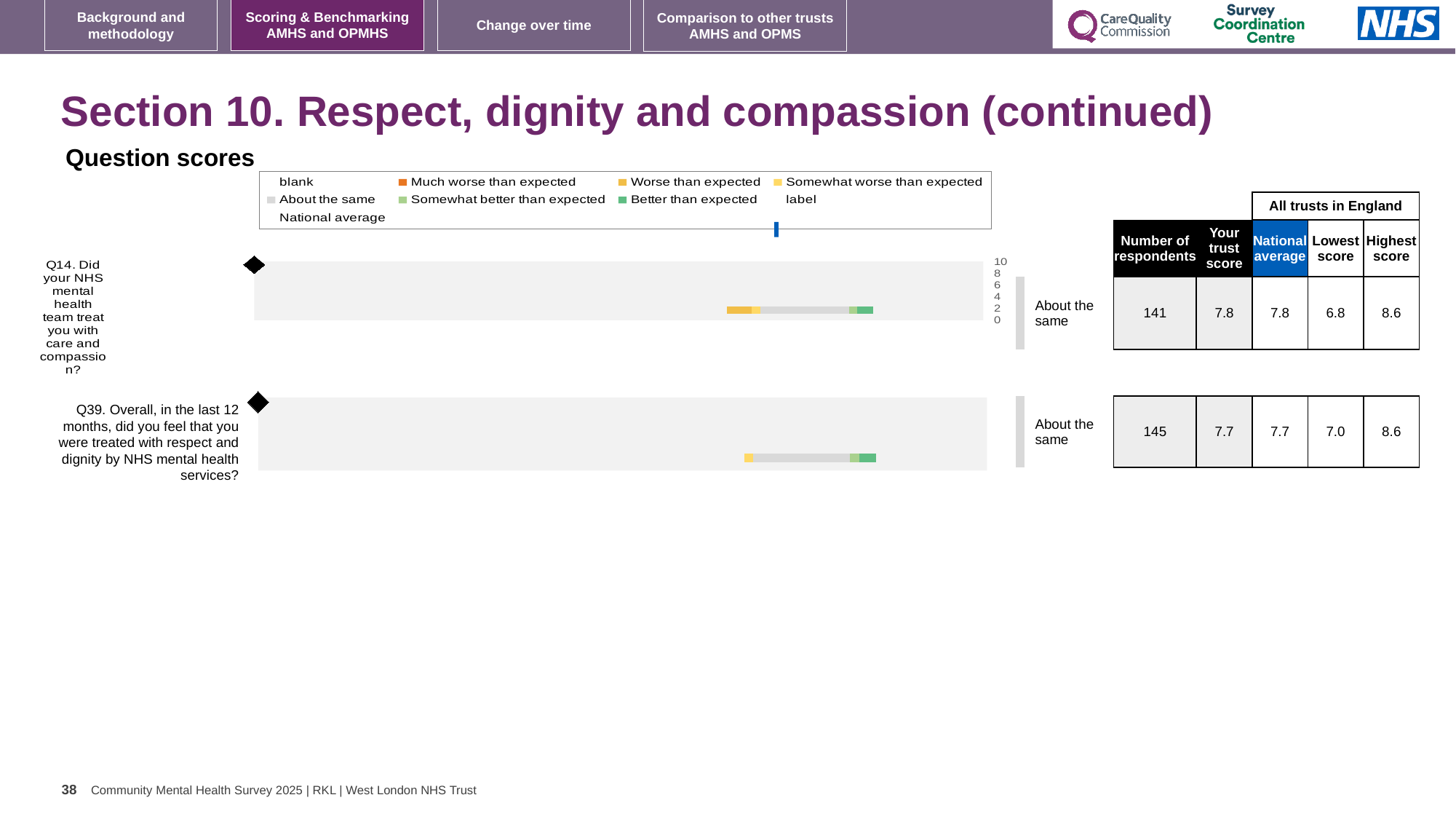
What is the trust score for Q14 (care and compassion)? 7.8 What is the national average score for Q39? 7.7 How many respondents answered Q39? 145 Which legend entry is shown with an orange marker? Much worse than expected What benchmark category is the trust placed in for Q14? About the same Which question has the higher trust score, Q14 or Q39? Q14 What kind of chart is used to show the question scores for Q14 and Q39? bar chart What is the highest score among all trusts in England for Q39? 8.6 What is the lowest score among all trusts in England for Q14? 6.8 How many questions are plotted in the question scores chart? 2 What is the trust score for Q39 (treated with respect and dignity)? 7.7 What is the difference between the highest and lowest trust scores in England for Q14? 1.8